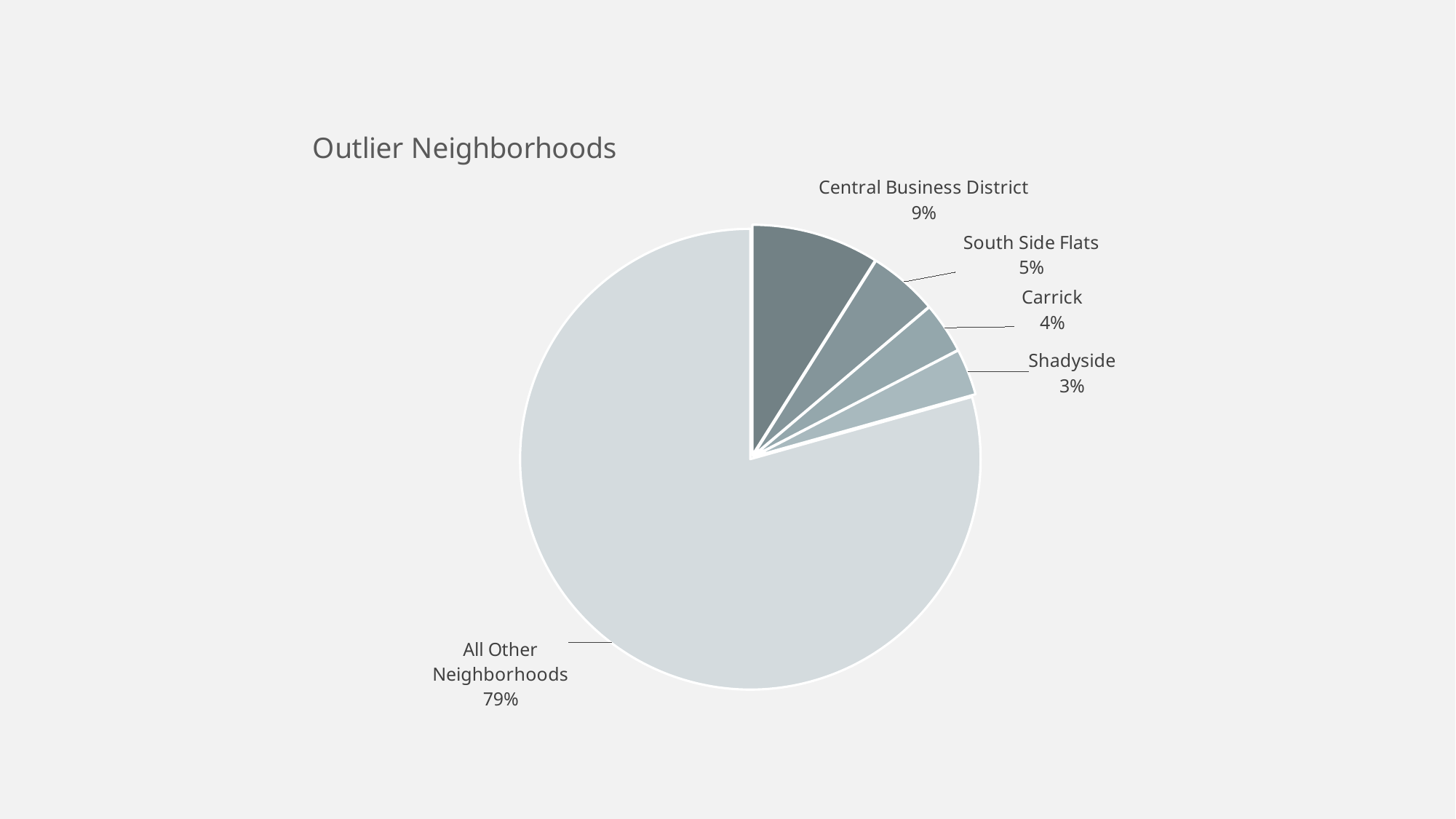
What share of the pie does Shadyside represent? 3% Which slice is the smallest? Shadyside What share of the pie does Central Business District represent? 9% What share of the pie does Carrick represent? 4% How many slices does the pie chart have? 5 Which is larger, the share for Carrick or the share for Shadyside? Carrick What is the difference in percentage points between Central Business District and South Side Flats? 4 Which slice is the largest? All Other Neighborhoods What kind of chart is shown on the slide? Pie chart What is the title of the chart? Outlier Neighborhoods